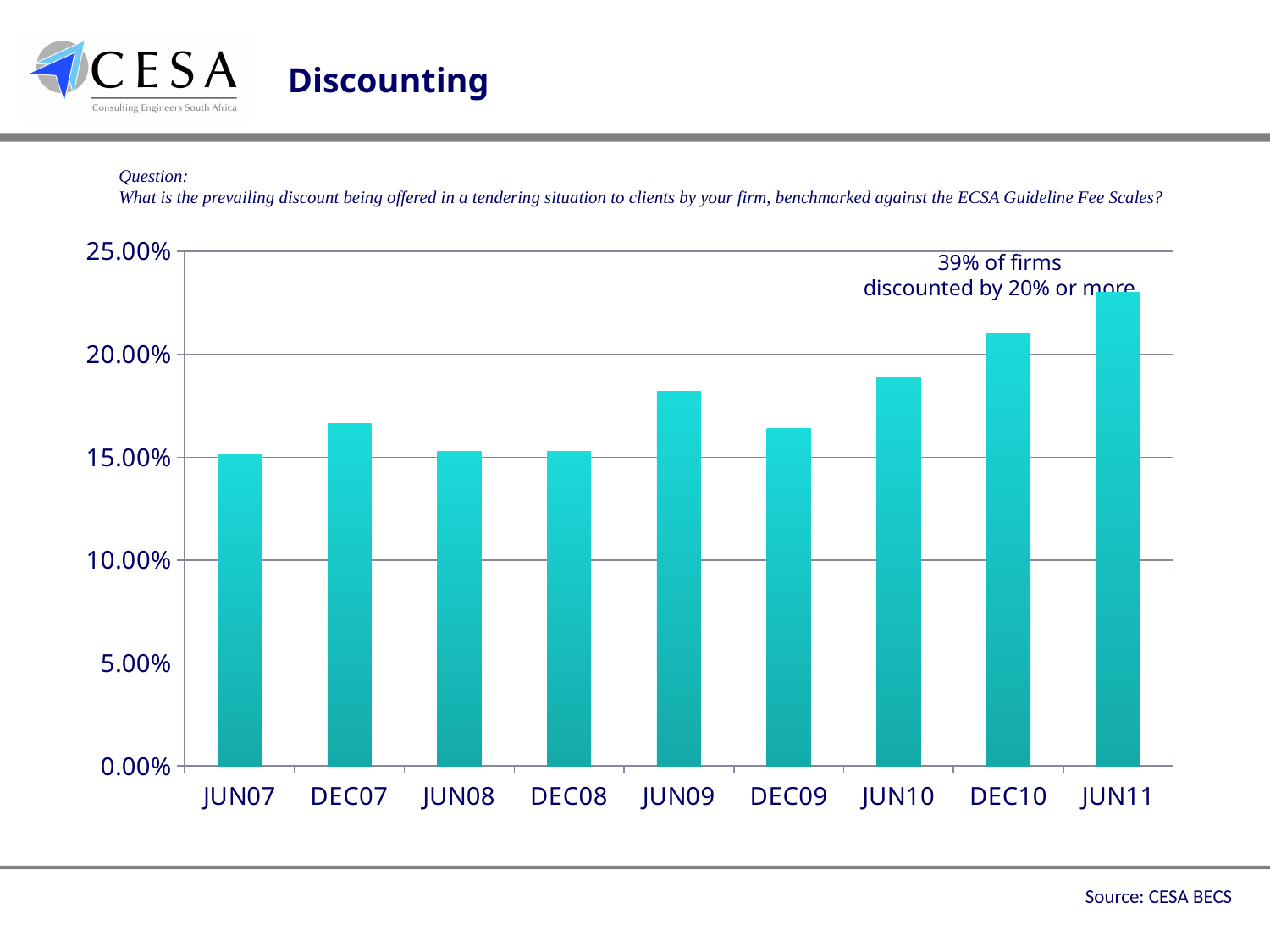
Which period has the highest discount value in the chart? JUN11 What kind of chart is shown on the slide? bar chart According to the annotation on the chart, what percentage of firms discounted by 20% or more? 39% Is the value for JUN09 greater or less than 20.00%? less Is the value for JUN11 greater or less than 20.00%? greater Which is larger, the value for JUN09 or the value for DEC09? JUN09 Do the values generally rise or fall from JUN07 to JUN11? rise How many periods are shown on the x axis of the chart? 9 Is the value for DEC10 greater or less than 20.00%? greater Which is larger, the value for DEC10 or the value for DEC09? DEC10